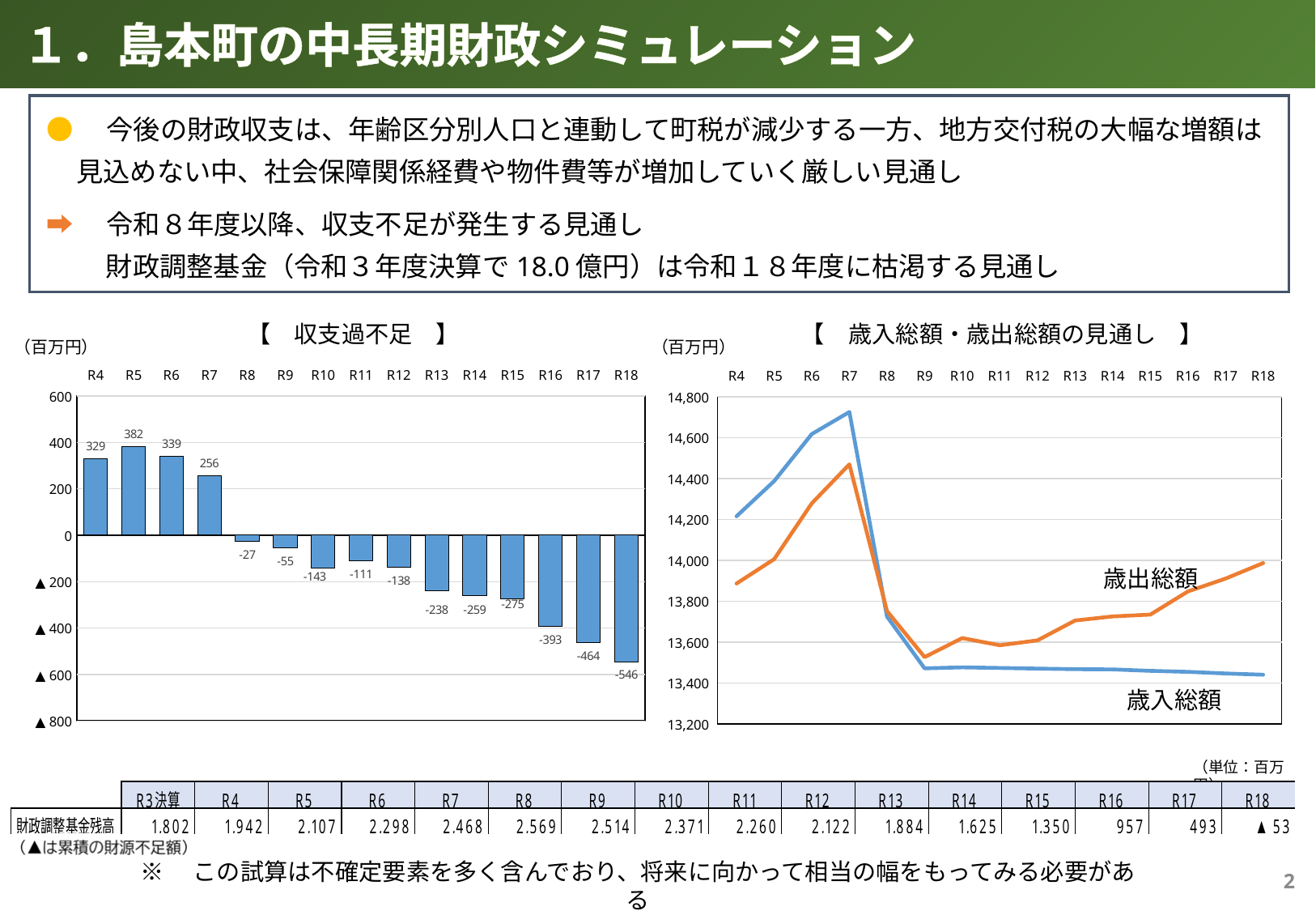
In the 歳入総額・歳出総額の見通し chart, how many series are plotted? 2 In the 収支過不足 chart, which is larger, the value for R10 or the value for R11? R11 In the 収支過不足 chart, how many years are plotted? 15 In the 収支過不足 chart, what is the value for R18? -546 In the 歳入総額・歳出総額の見通し chart, is the value of 歳出総額 at R4 greater or less than 14,000? less In the 収支過不足 chart, what is the difference between the values for R4 and R7? 73 In the 収支過不足 chart, what is the value for R5? 382 In the 収支過不足 chart, which year has the lowest value? R18 In the 歳入総額・歳出総額の見通し chart, is the value of 歳入総額 at R7 greater or less than 14,600? greater In the 収支過不足 chart, which year has the highest value? R5 What kind of chart is the 収支過不足 chart? Bar chart In the 歳入総額・歳出総額の見通し chart, which series is higher at R18, 歳入総額 or 歳出総額? 歳出総額